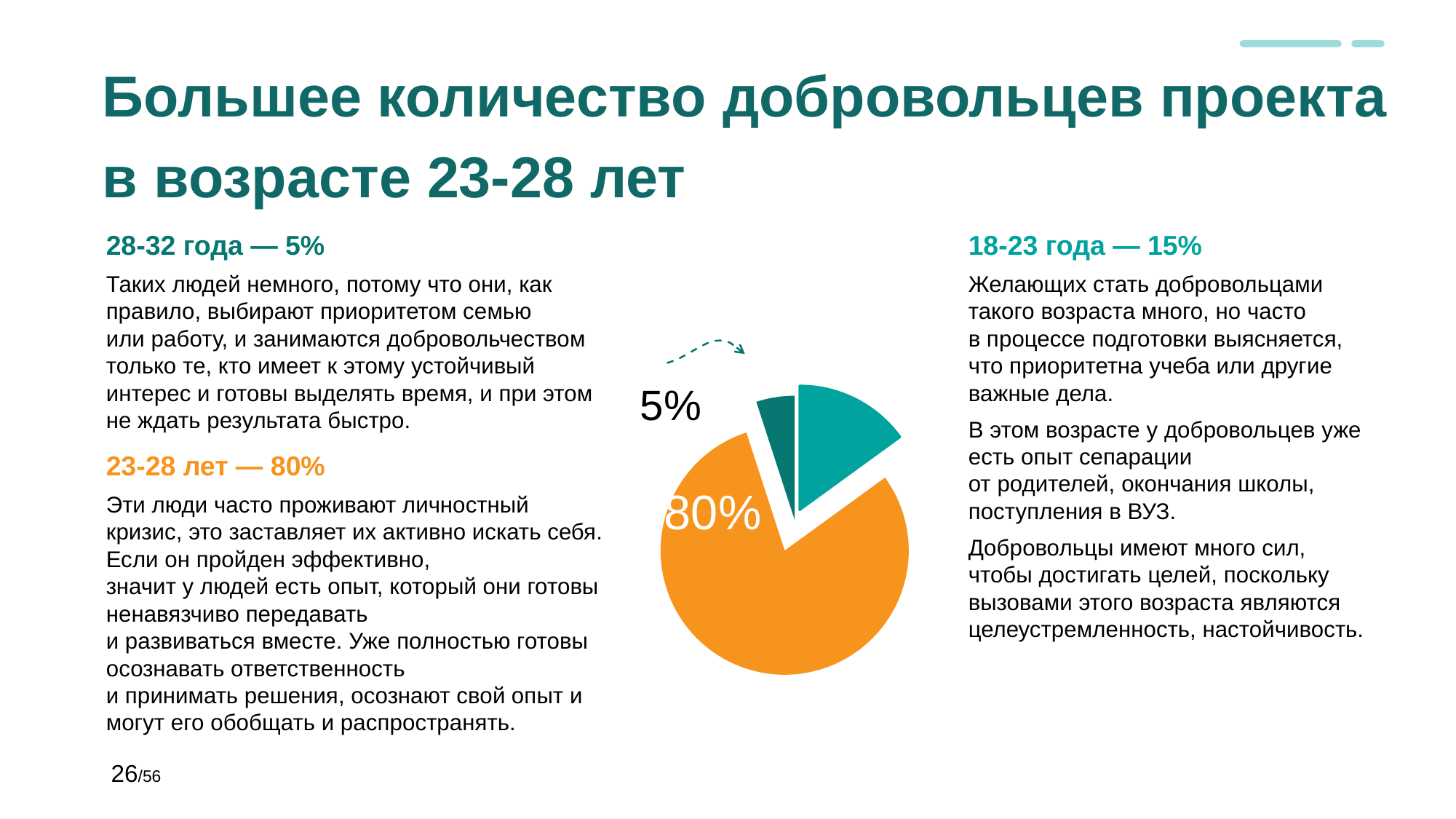
Which is larger, the share for 18-23 года or the share for 28-32 года? 18-23 года What is the difference between the share for 23-28 лет and the share for 18-23 года? 65% What share of the pie is labelled 80%? 80% What percentage is shown for the 18-23 года age group? 15% What colour is the largest slice of the pie chart? orange Which age group has the largest slice of the pie? 23-28 лет How many slices does the pie chart have? 3 What kind of chart is shown on the slide? pie chart What is the difference between the share for 18-23 года and the share for 28-32 года? 10% What percentage is shown for the 23-28 лет age group? 80% Which age group has the smallest slice of the pie? 28-32 года What percentage is shown for the 28-32 года age group? 5%